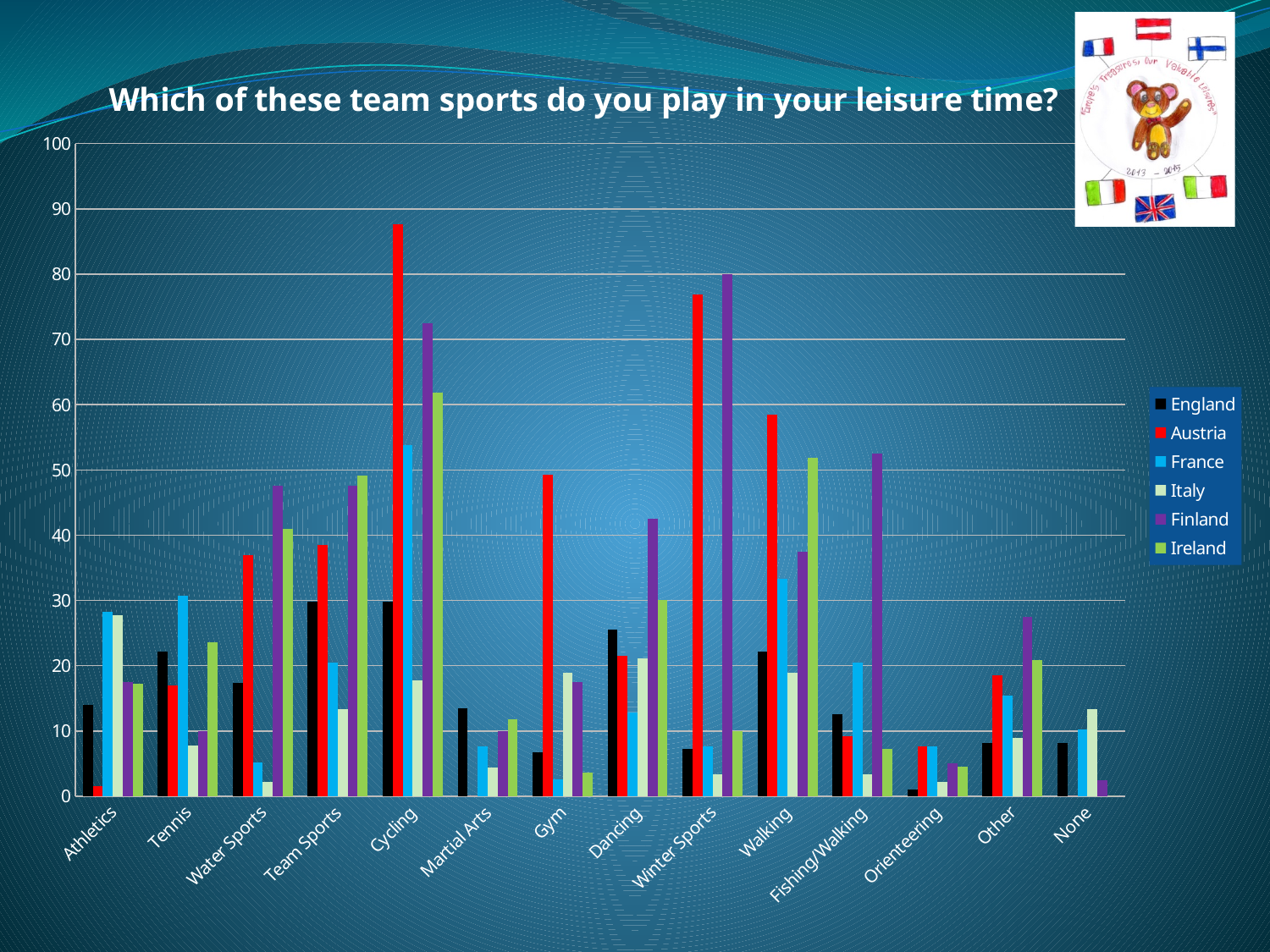
Which country has the lowest bar for Winter Sports? Italy For Walking, which is larger: the Austria bar or the Ireland bar? Austria Which country has the lowest bar for Cycling? Italy What is the title of the chart? Which of these team sports do you play in your leisure time? For which activity is the Finland bar highest? Winter Sports Which country has the tallest bar in the whole chart, and for which activity? Austria, Cycling Is the value for Austria in Cycling greater or less than 80? greater What kind of chart is shown on the slide? Bar chart Is the value for Austria in Orienteering greater or less than 10? less How many activity categories are shown on the x axis? 14 For which activity is the Ireland bar highest? Cycling How many series does the legend list? 6